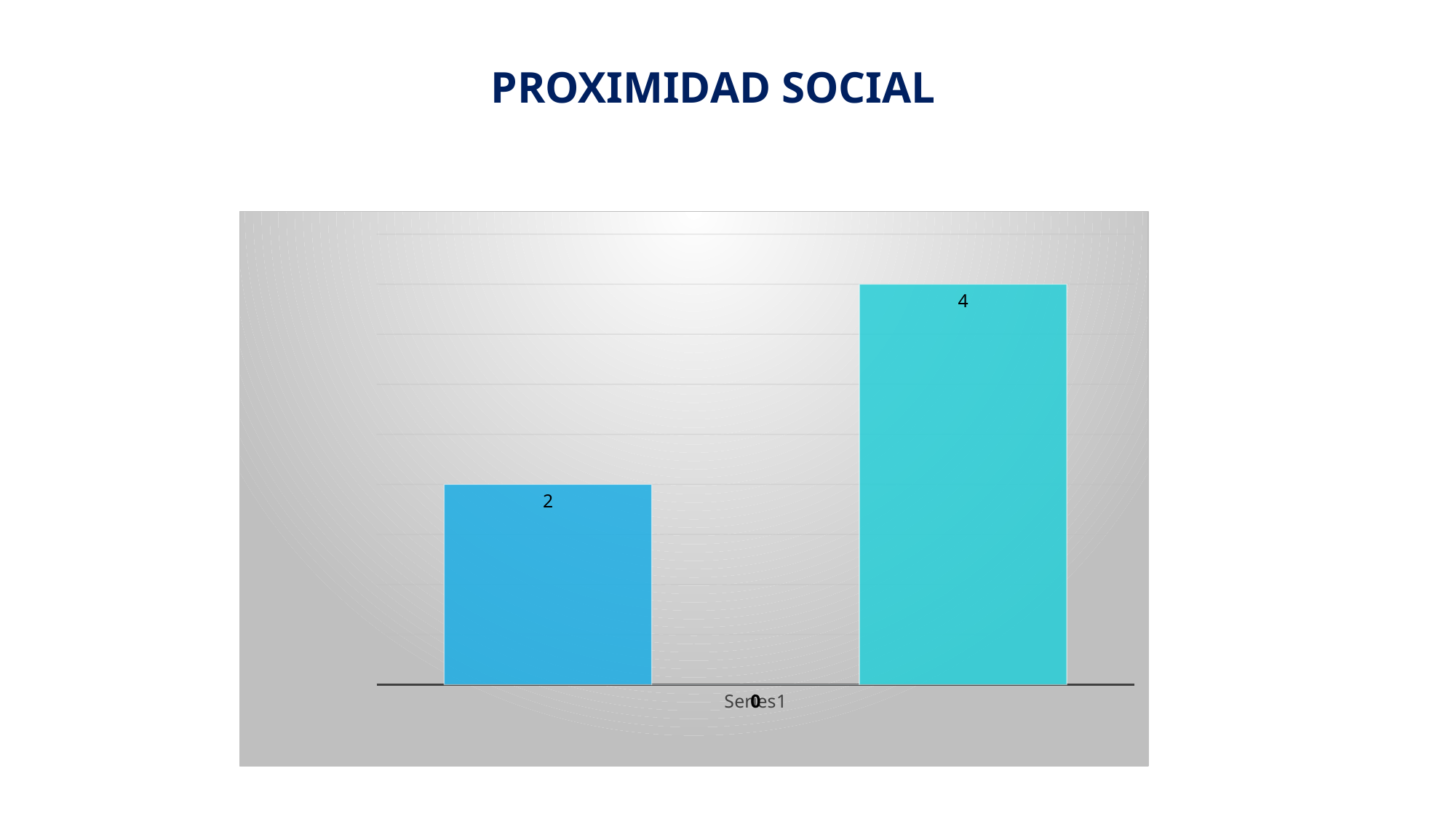
What is the value printed on the right (teal) bar? 4 What category label is printed on the x axis of the chart? Series1 What kind of chart is shown on the slide? bar chart Which bar has the lowest labelled value, the left blue bar or the right teal bar? the left blue bar Is the value of the left blue bar larger or smaller than the value of the right teal bar? smaller How many bars are drawn in the chart? 2 Which bar is taller, the left blue bar or the right teal bar? the right teal bar What is the value printed on the left (blue) bar? 2 What is the difference between the value of the right bar and the value of the left bar? 2 What is the title shown above the chart on the slide? PROXIMIDAD SOCIAL